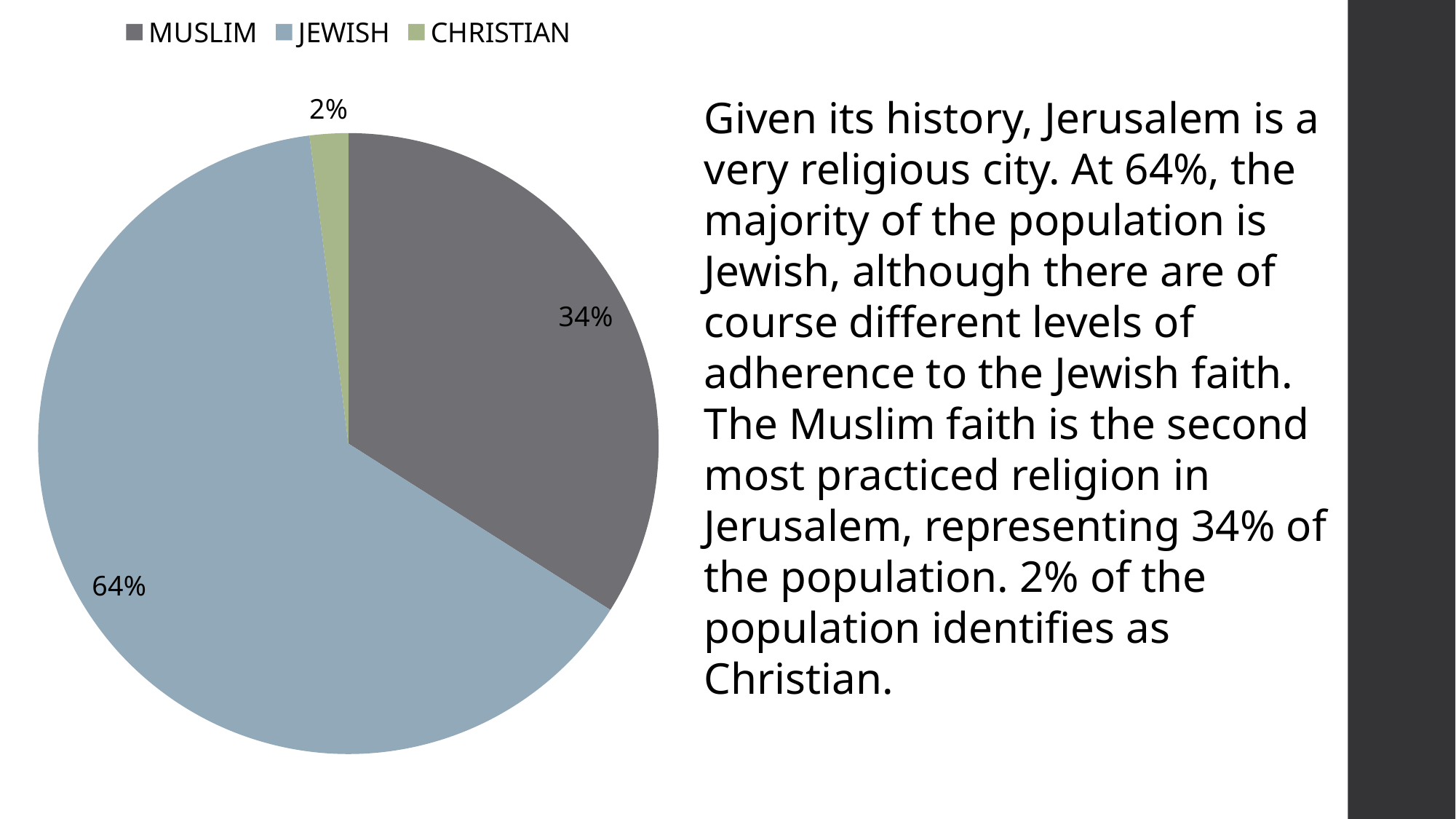
What colour is the JEWISH slice in the pie chart? blue-grey What share of the pie does the MUSLIM slice represent? 34% What share of the pie does the CHRISTIAN slice represent? 2% How many entries does the legend list? 3 What kind of chart is shown on the slide? pie chart What is the difference in percentage points between the JEWISH and MUSLIM slices? 30 What share of the pie does the JEWISH slice represent? 64% What is the difference in percentage points between the MUSLIM and CHRISTIAN slices? 32 Which slice is larger, MUSLIM or CHRISTIAN? MUSLIM How many slices does the pie chart have? 3 Which category has the largest slice of the pie? JEWISH Which category has the smallest slice of the pie? CHRISTIAN